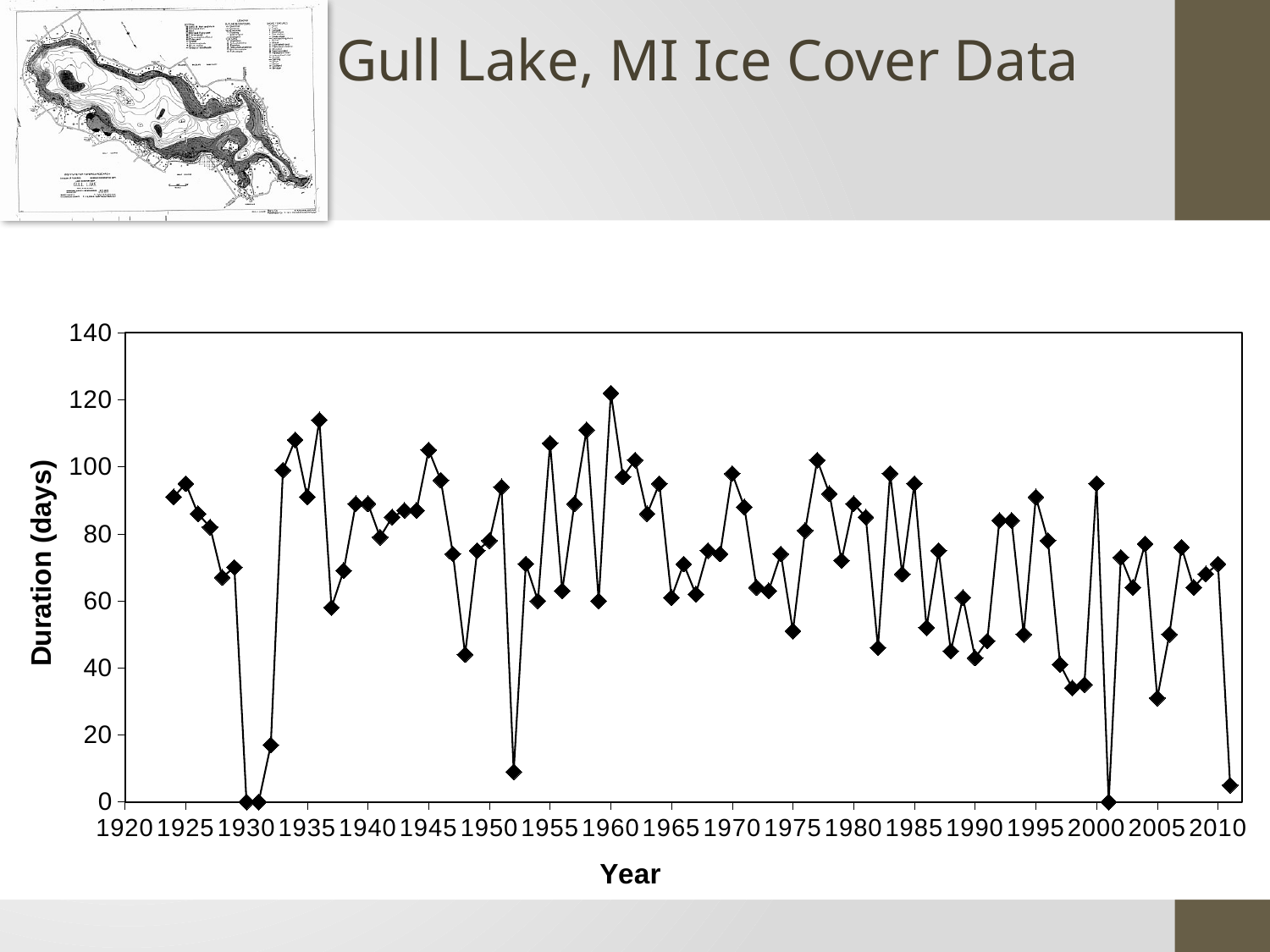
Is the value for 2005 greater or less than 40? less In which year does the ice cover duration reach its highest value? 1960 Is the value for 1955 greater or less than 100? greater What kind of chart is shown on the slide? line chart Is the value for 1985 greater or less than 80? greater What is the label on the vertical axis of the chart? Duration (days) Which is larger, the value for 1960 or the value for 2005? 1960 What is the label on the horizontal axis of the chart? Year